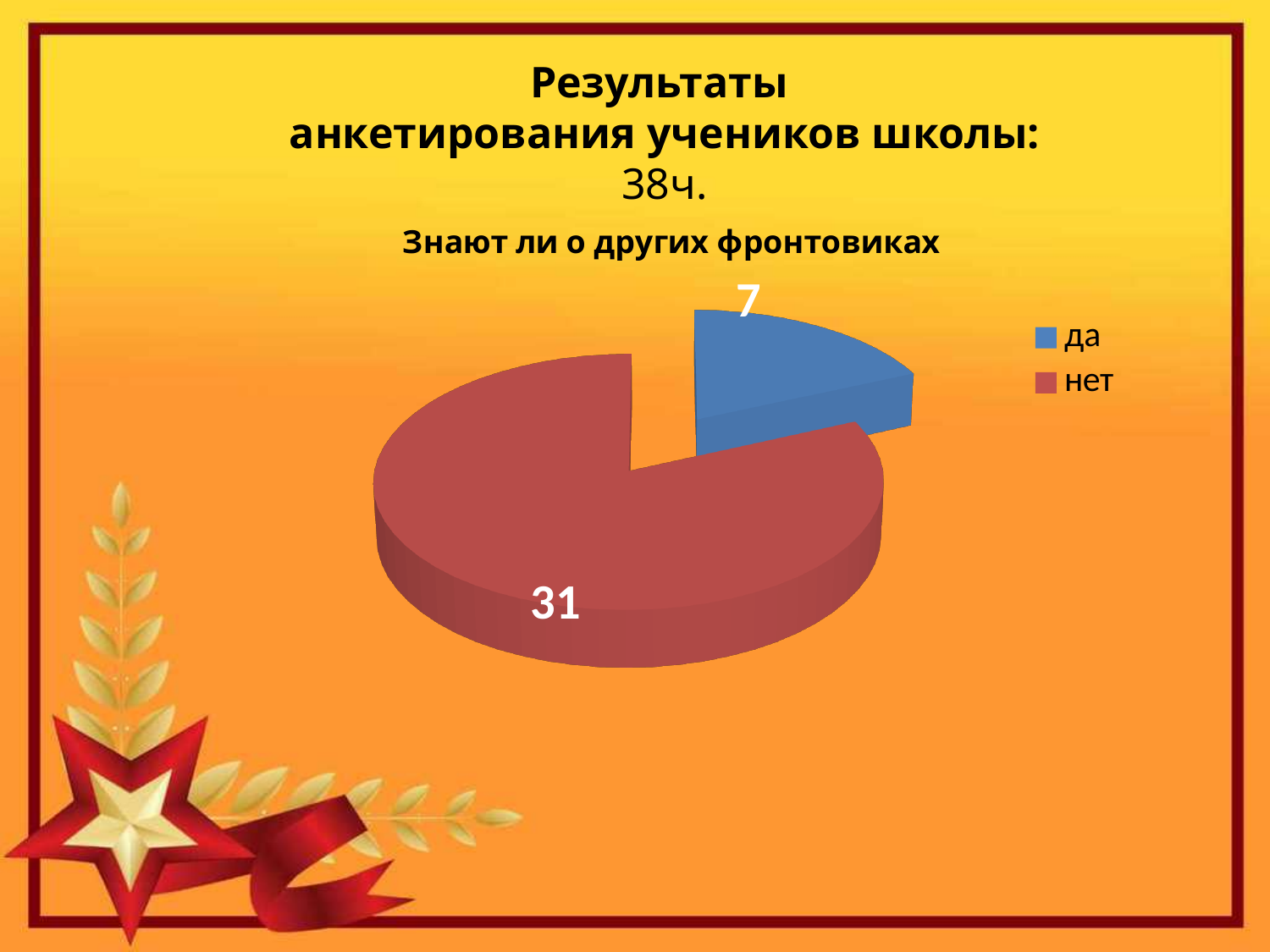
What is the title of the chart? Знают ли о других фронтовиках Which category has the largest slice? нет How many slices does the pie chart have? 2 How many entries does the legend list? 2 What is the value for "нет"? 31 Which category has the smallest slice? да What type of chart is shown on the slide? pie chart What is the total of all slices in the pie chart? 38 What is the difference between the values for "нет" and "да"? 24 What colour is the slice for "да"? blue Which is larger, the value for "да" or the value for "нет"? нет What is the value for "да"? 7